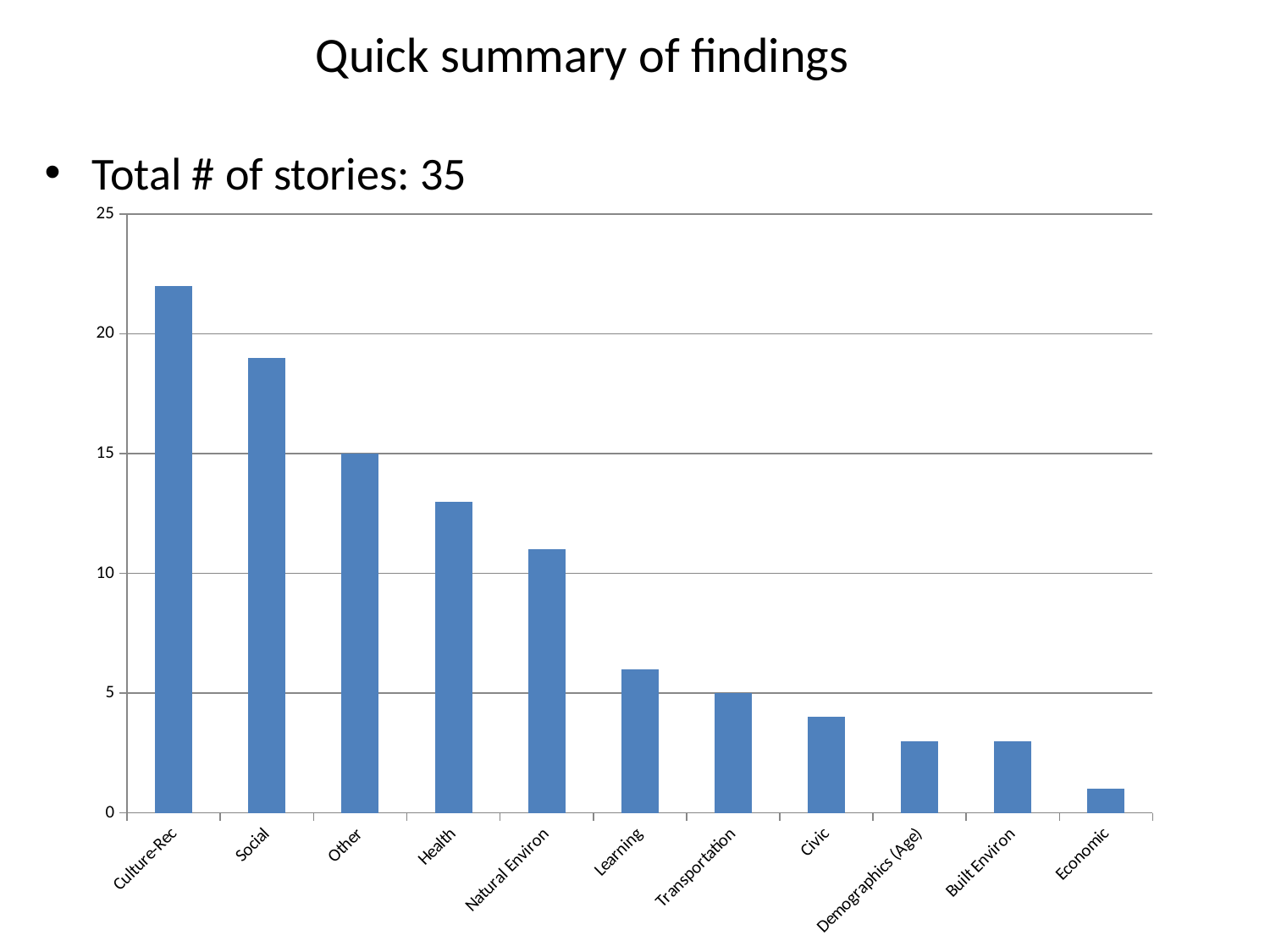
Is the value for Culture-Rec greater or less than 20? greater How many categories are shown on the x axis of the chart? 11 What kind of chart is shown on the slide? bar chart Is the value for Natural Environ greater or less than 10? greater Which is larger, the value for Social or the value for Health? Social What is the value for Other in the chart? 15 Which category has the lowest bar in the chart? Economic Is the value for Social greater or less than 20? less What is the value for Transportation in the chart? 5 Do the bar values rise or fall from left to right along the x axis? fall Which category has the highest bar in the chart? Culture-Rec